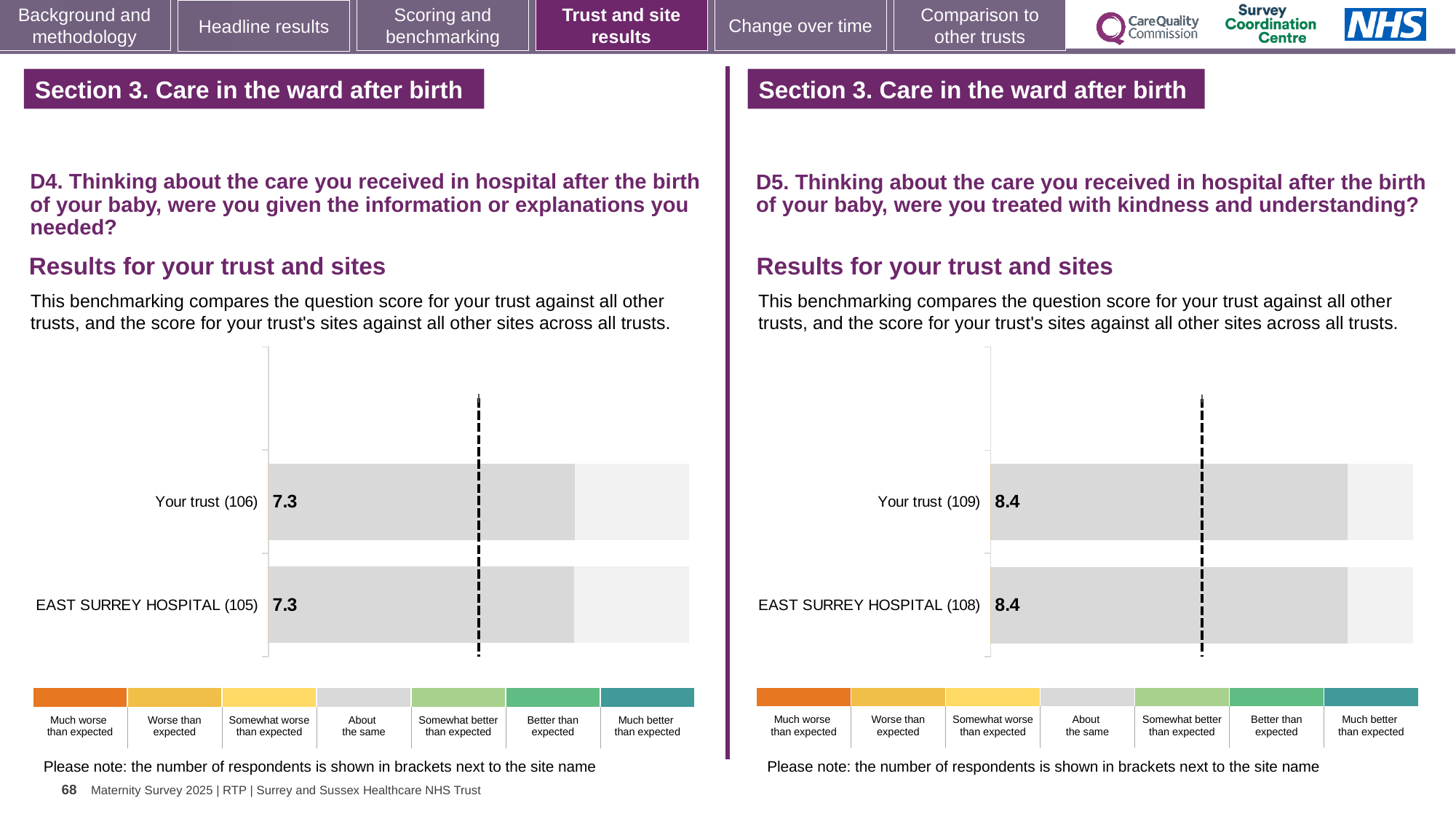
In the right chart (D5), what is the score for EAST SURREY HOSPITAL? 8.4 How many categories does the colour key below the right chart (D5) list? 7 In the left chart (D4), what is the difference between the score for Your trust and the score for EAST SURREY HOSPITAL? 0 In the left chart (D4), what is the score for Your trust? 7.3 In the right chart (D5), what is the score for Your trust? 8.4 In the right chart (D5), what is the difference between the score for Your trust and the score for EAST SURREY HOSPITAL? 0 How many bars are plotted in the right chart (D5)? 2 How many bars are plotted in the left chart (D4)? 2 In the left chart (D4), what is the score for EAST SURREY HOSPITAL? 7.3 What kind of chart is used in the left chart (D4)? Bar chart In the left chart (D4), how many respondents are shown in brackets for Your trust? 106 In the right chart (D5), how many respondents are shown in brackets for EAST SURREY HOSPITAL? 108